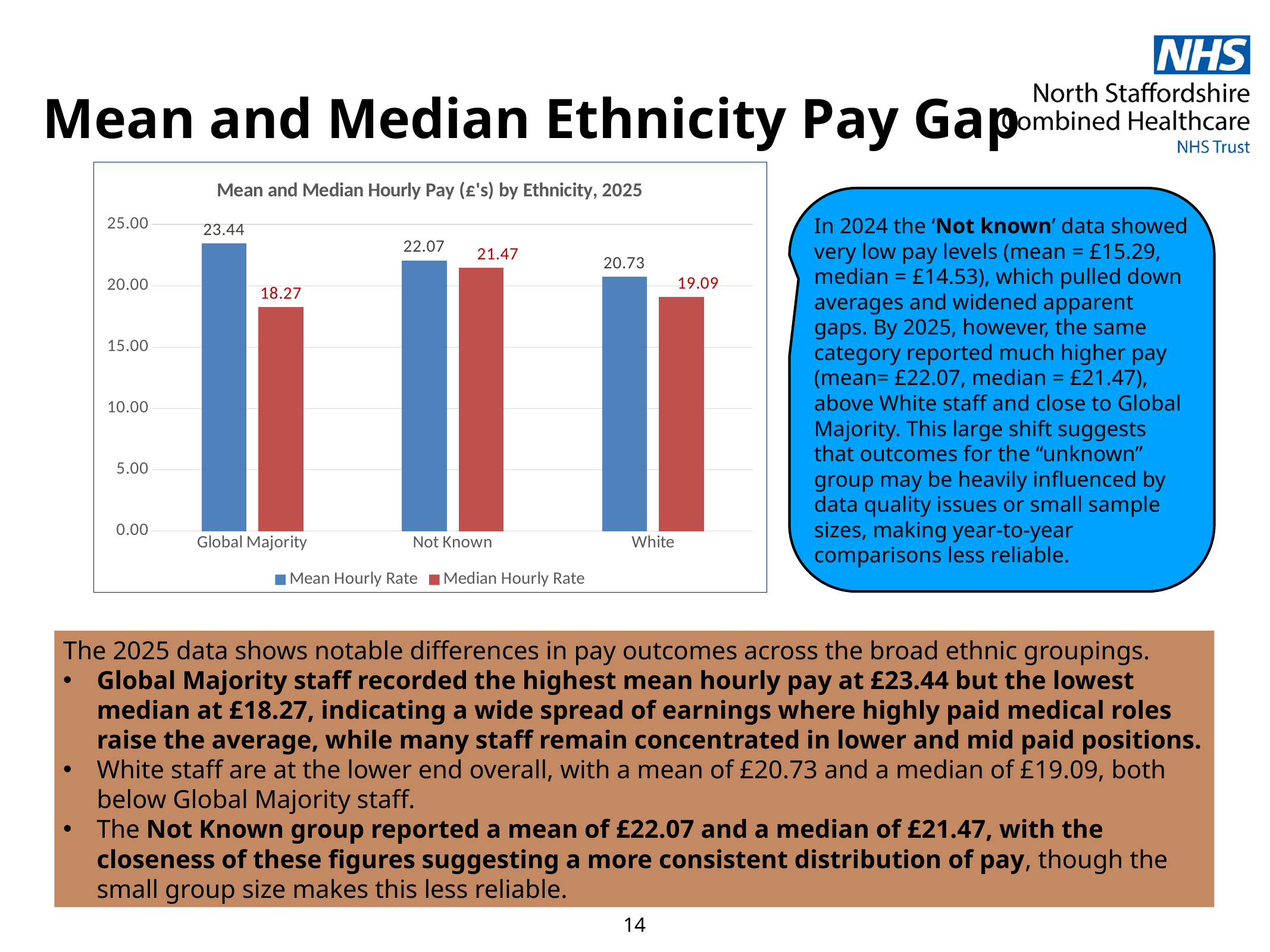
Which is larger, the Mean Hourly Rate for Not Known or the Mean Hourly Rate for White? Not Known What is the Median Hourly Rate for White? 19.09 What is the Mean Hourly Rate for Global Majority? 23.44 Is the Median Hourly Rate for Global Majority greater or less than 20.00? less What is the Median Hourly Rate for Not Known? 21.47 What is the title of the chart? Mean and Median Hourly Pay (£'s) by Ethnicity, 2025 How many series does the legend list? 2 What kind of chart is shown on the slide? Bar chart Which ethnicity category has the lowest Median Hourly Rate? Global Majority How many ethnicity categories are shown on the x axis? 3 What is the difference between the Mean Hourly Rate and the Median Hourly Rate for Global Majority? 5.17 Which ethnicity category has the highest Mean Hourly Rate? Global Majority